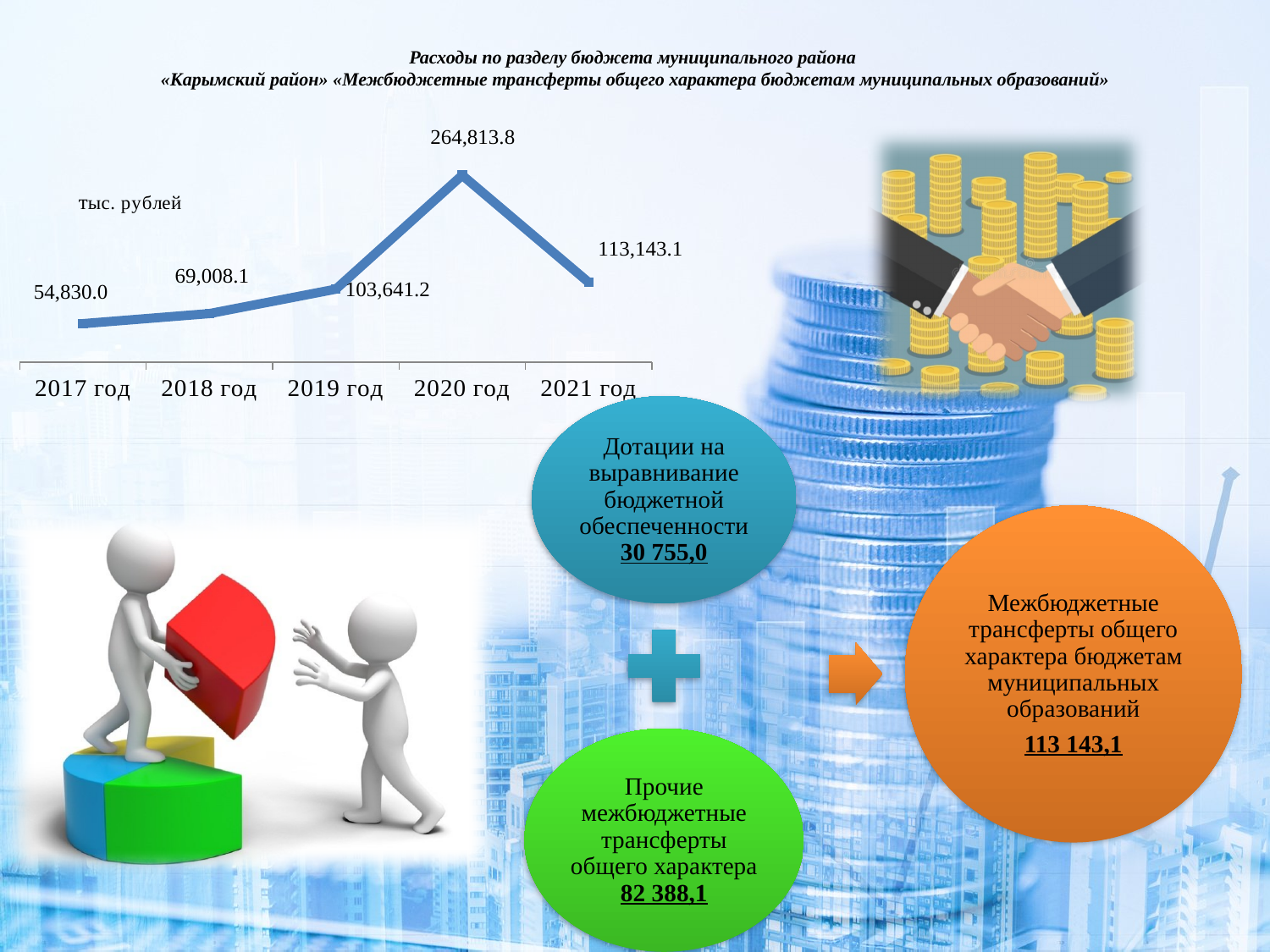
What kind of chart is shown on the slide? line chart What is the value for 2017 год on the line chart? 54,830.0 What is the value for 2020 год on the line chart? 264,813.8 How many years are plotted on the line chart? 5 What is the difference between the values for 2018 год and 2017 год on the line chart? 14,178.1 Which year has the lowest value on the line chart? 2017 год What is the value for 2021 год on the line chart? 113,143.1 What is the difference between the values for 2020 год and 2021 год on the line chart? 151,670.7 Which is larger on the line chart, the value for 2019 год or the value for 2021 год? 2021 год In what units are the values on the line chart expressed? тыс. рублей Which year has the highest value on the line chart? 2020 год What is the value for 2019 год on the line chart? 103,641.2